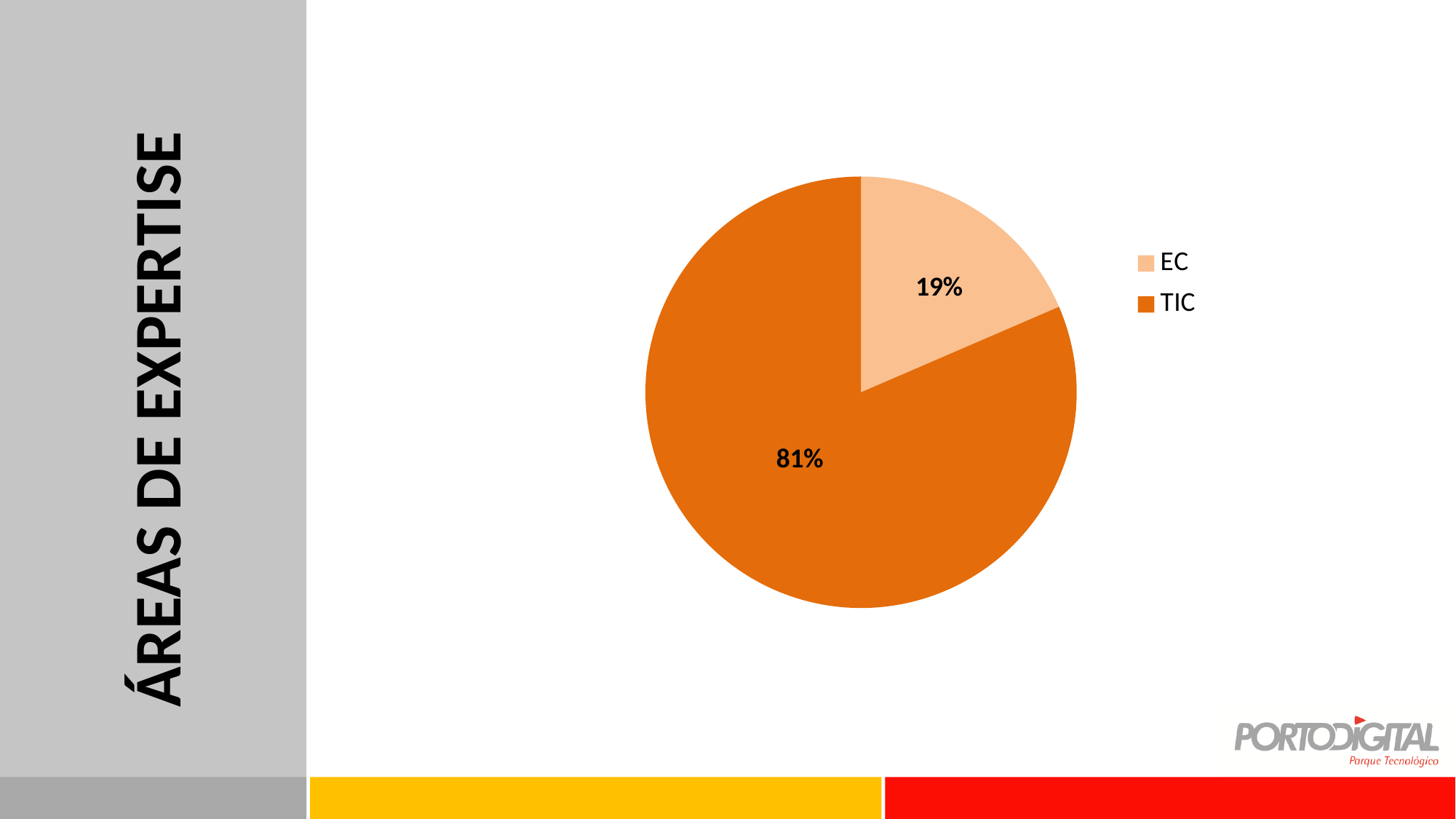
What share of the pie does TIC represent? 81% How many slices does the pie chart have? 2 How many entries does the legend list? 2 Which is larger, the EC slice or the TIC slice? TIC What is the title shown on the slide next to the chart? ÁREAS DE EXPERTISE Which category has the smallest slice of the pie? EC What kind of chart is shown on the slide? pie chart Which category has the largest slice of the pie? TIC What share of the pie does EC represent? 19% Which legend entry is shown in the darker orange colour? TIC What is the difference in percentage points between the TIC and EC slices? 62